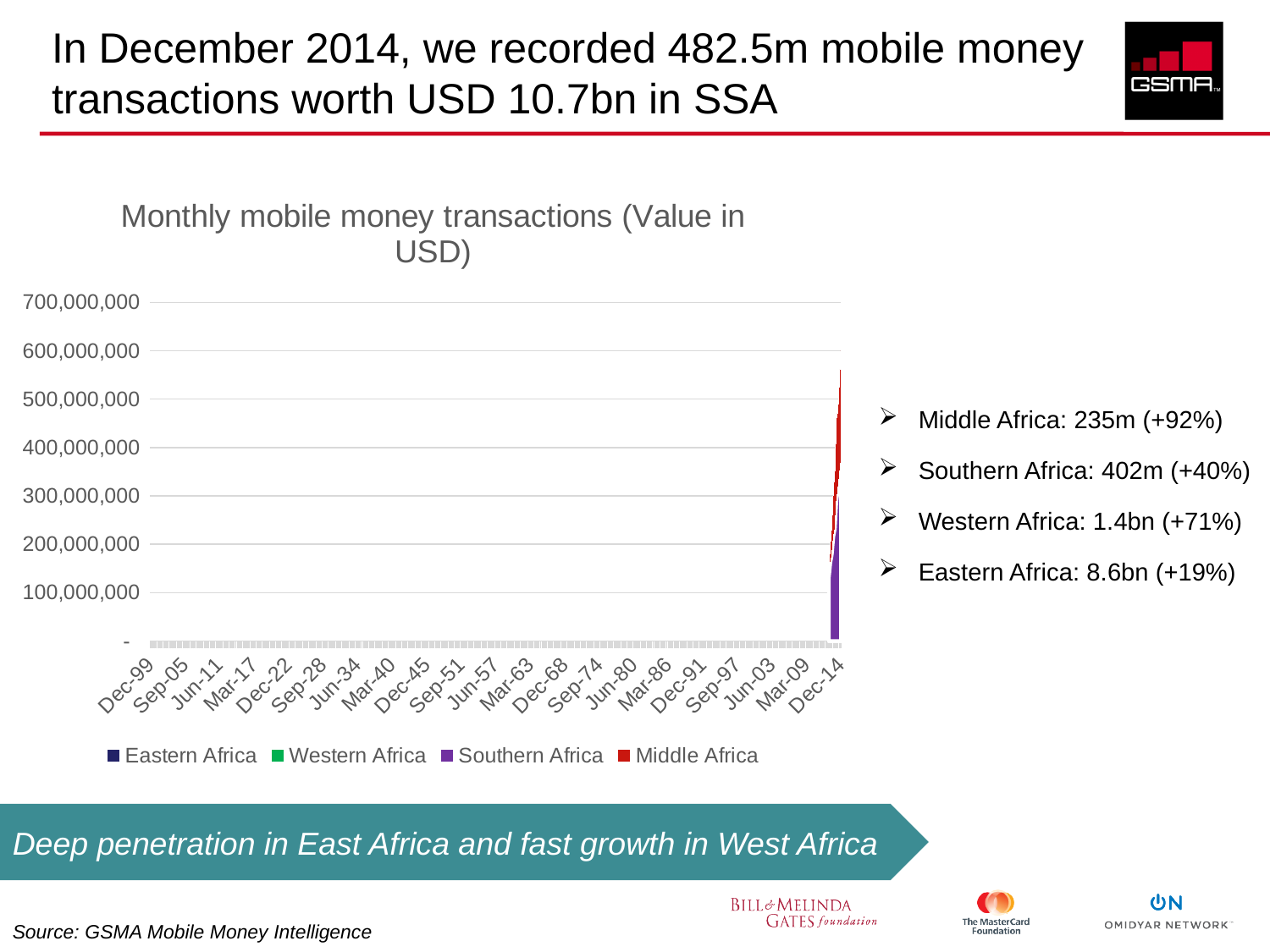
How many series does the legend of the chart list? 4 What is the first category label on the x axis of the chart? Dec-99 What kind of chart is shown on the slide? area chart Which colour represents Middle Africa in the chart? red What is the last category label on the x axis of the chart? Dec-14 What is the title of the chart? Monthly mobile money transactions (Value in USD) What is the highest value shown on the y axis of the chart? 700,000,000